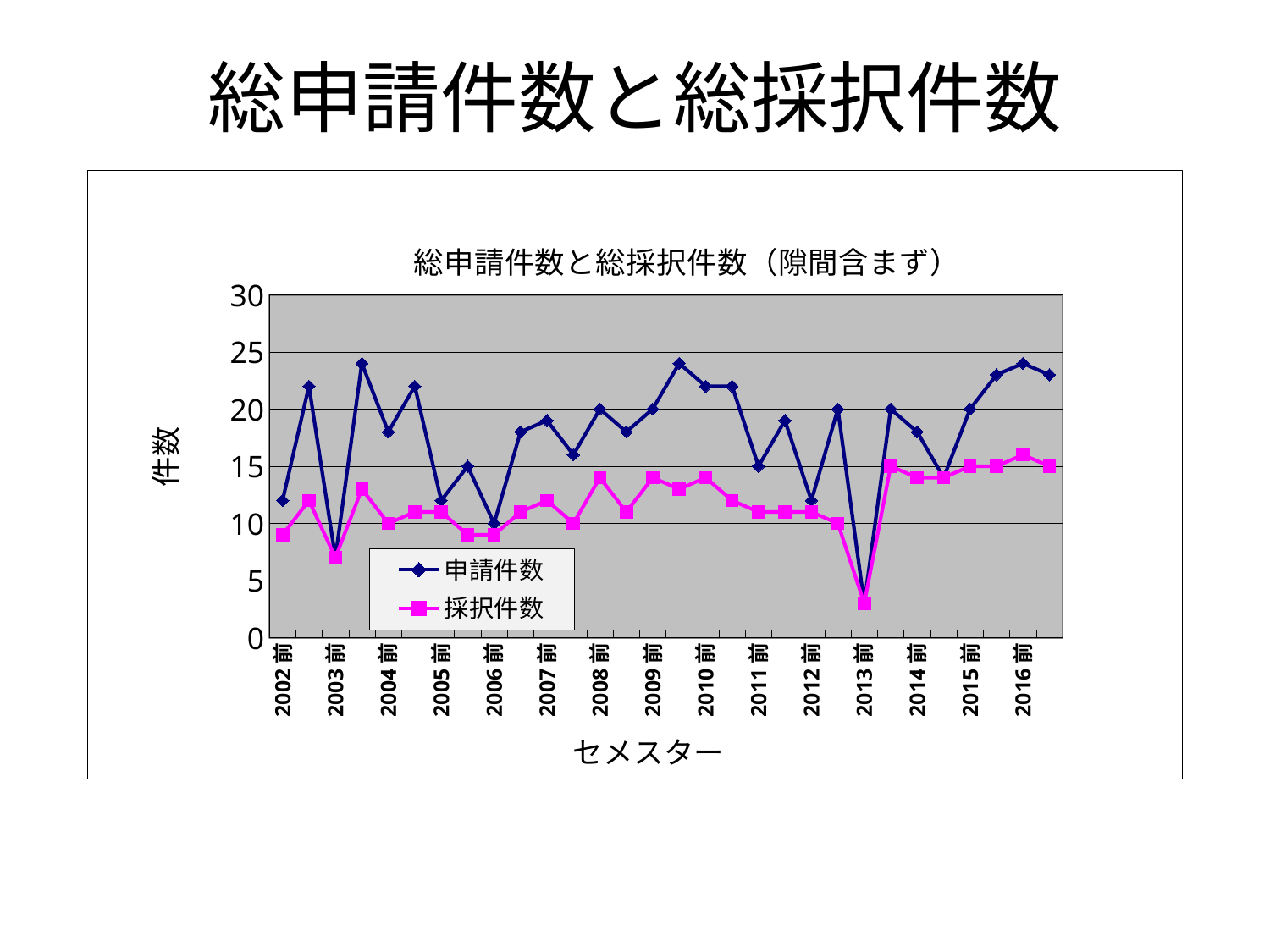
Is the value of 採択件数 at 2013前 greater or less than 5? less What is the title printed inside the chart area? 総申請件数と総採択件数（隙間含まず） At which x-axis label does 採択件数 reach its lowest value? 2013前 What kind of chart is shown on the slide? line chart Is the value of 申請件数 at 2016前 greater or less than 20? greater Is the value of 採択件数 at 2002前 greater or less than 10? less Does 採択件数 rise or fall from 2013前 to 2016前? rise How many series does the legend list? 2 At 2013前, which series has the larger value, 申請件数 or 採択件数? Neither; they are equal How many year labels (2002前 to 2016前) are shown on the x axis? 15 What are the two series named in the legend? 申請件数 and 採択件数